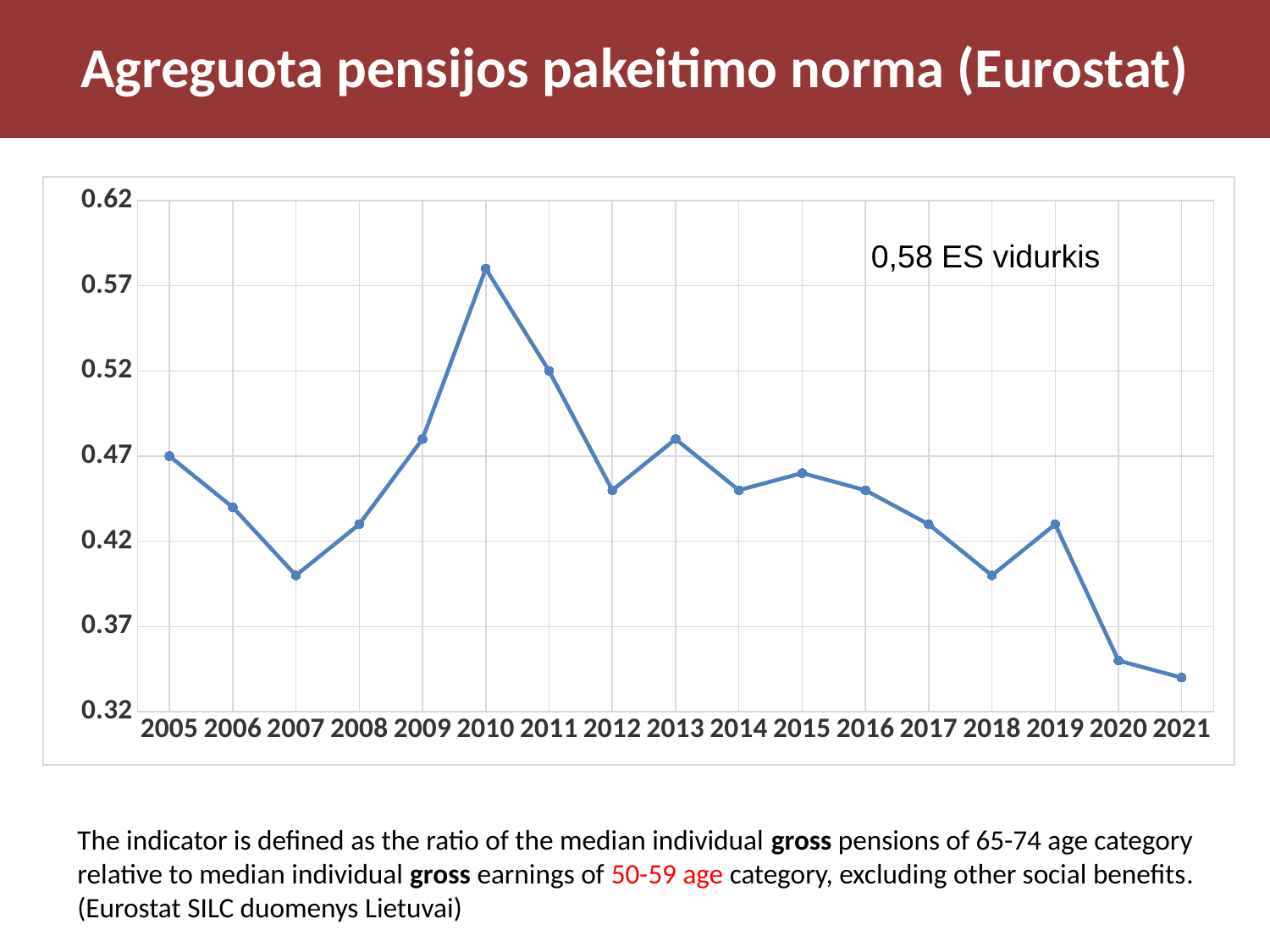
What kind of chart is shown on the slide? line chart Is the value for 2007 greater or less than 0.42? less Is the value for 2009 greater or less than 0.47? greater Do the values rise or fall from 2019 to 2021? fall Which year has the larger value, 2010 or 2011? 2010 Which year has the larger value, 2019 or 2020? 2019 How many years are plotted on the x axis of the chart? 17 Is the value for 2020 greater or less than 0.37? less In which year does the chart reach its highest value? 2010 In which year does the chart reach its lowest value? 2021 What EU average value is annotated on the chart? 0,58